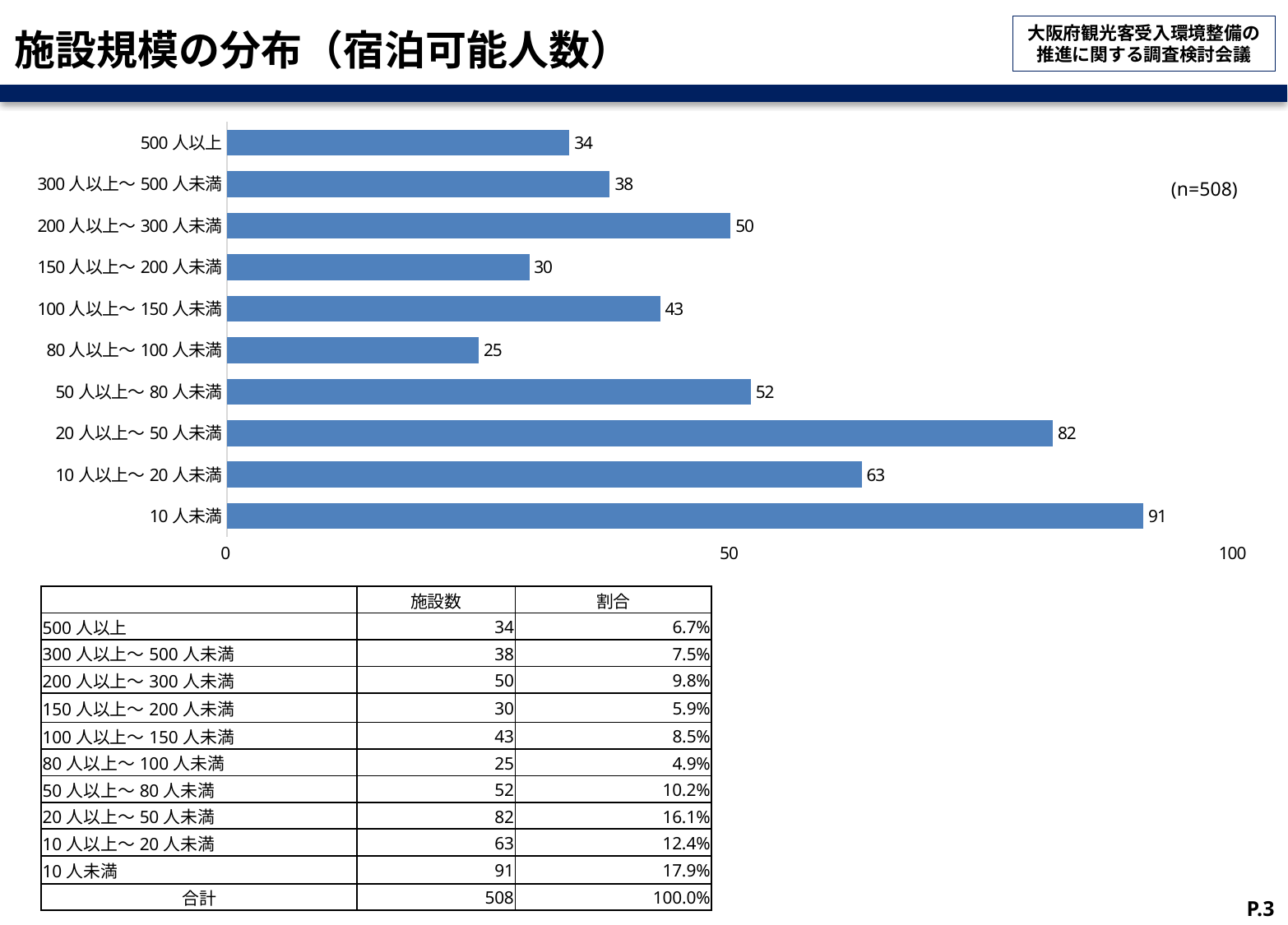
Which category has the lowest value? 80人以上～100人未満 What is the total of all the bar values in the chart? 508 What is the value for the 10人未満 category? 91 What kind of chart is shown on the slide? bar chart Which category has the highest value? 10人未満 What is the difference between the values for 20人以上～50人未満 and 10人以上～20人未満? 19 Is the value for 50人以上～80人未満 greater or less than 50? greater What is the value for the 80人以上～100人未満 category? 25 Which is larger, the value for 500人以上 or the value for 300人以上～500人未満? 300人以上～500人未満 How many categories are shown in the chart? 10 What is the title of the slide containing the chart? 施設規模の分布（宿泊可能人数） What is the value for the 200人以上～300人未満 category? 50